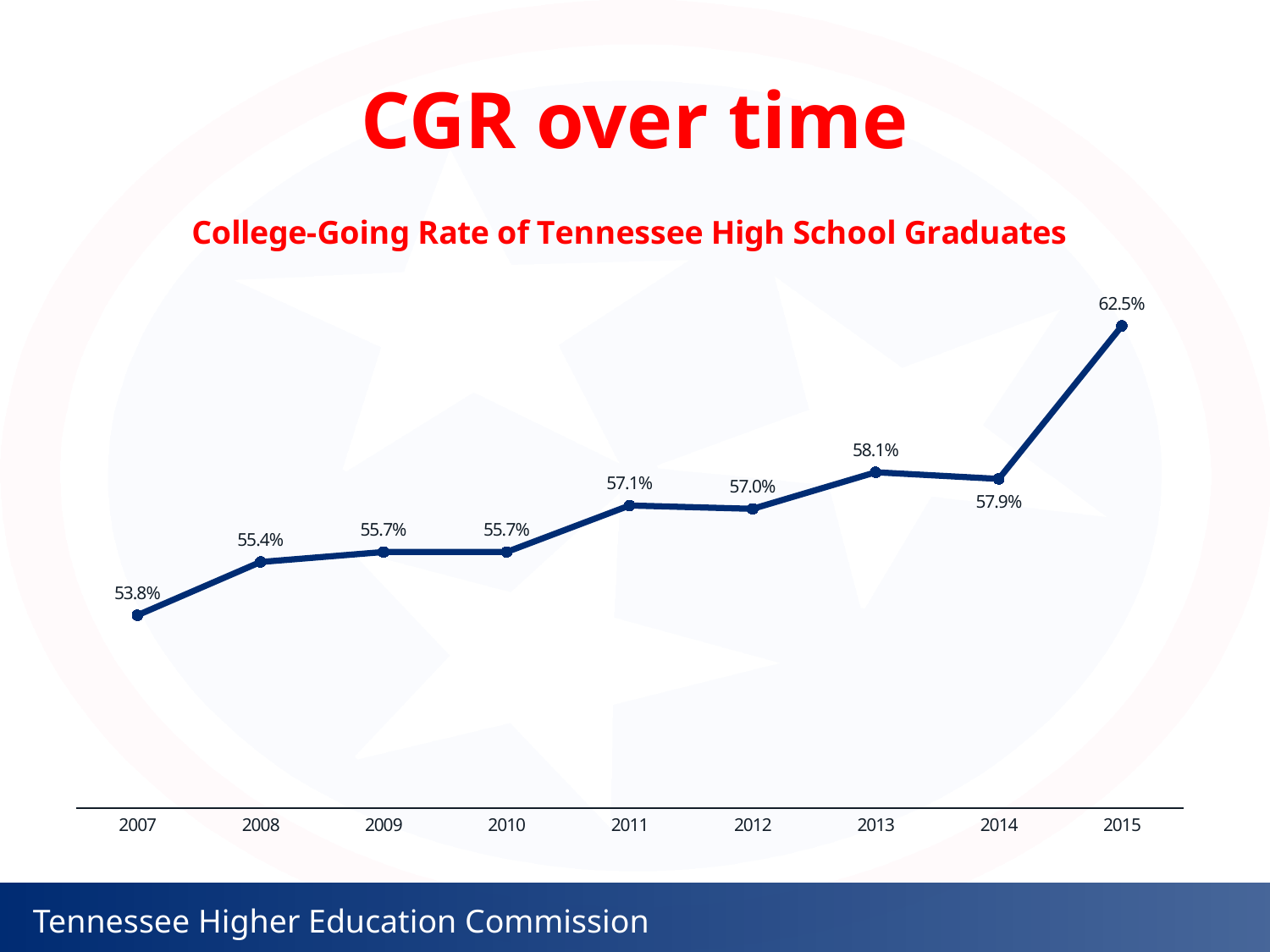
What is the college-going rate for 2011? 57.1% What kind of chart is shown on the slide? Line chart What is the difference between the college-going rate in 2015 and in 2014? 4.6% Which year has the lowest college-going rate? 2007 Which year has a higher college-going rate, 2013 or 2014? 2013 How many years are plotted on the chart? 9 What is the college-going rate for 2015? 62.5% What is the college-going rate for 2013? 58.1% Which year has the highest college-going rate? 2015 Does the college-going rate generally rise or fall from 2007 to 2015? Rise What is the difference between the college-going rate in 2015 and in 2007? 8.7% What is the college-going rate for 2007? 53.8%